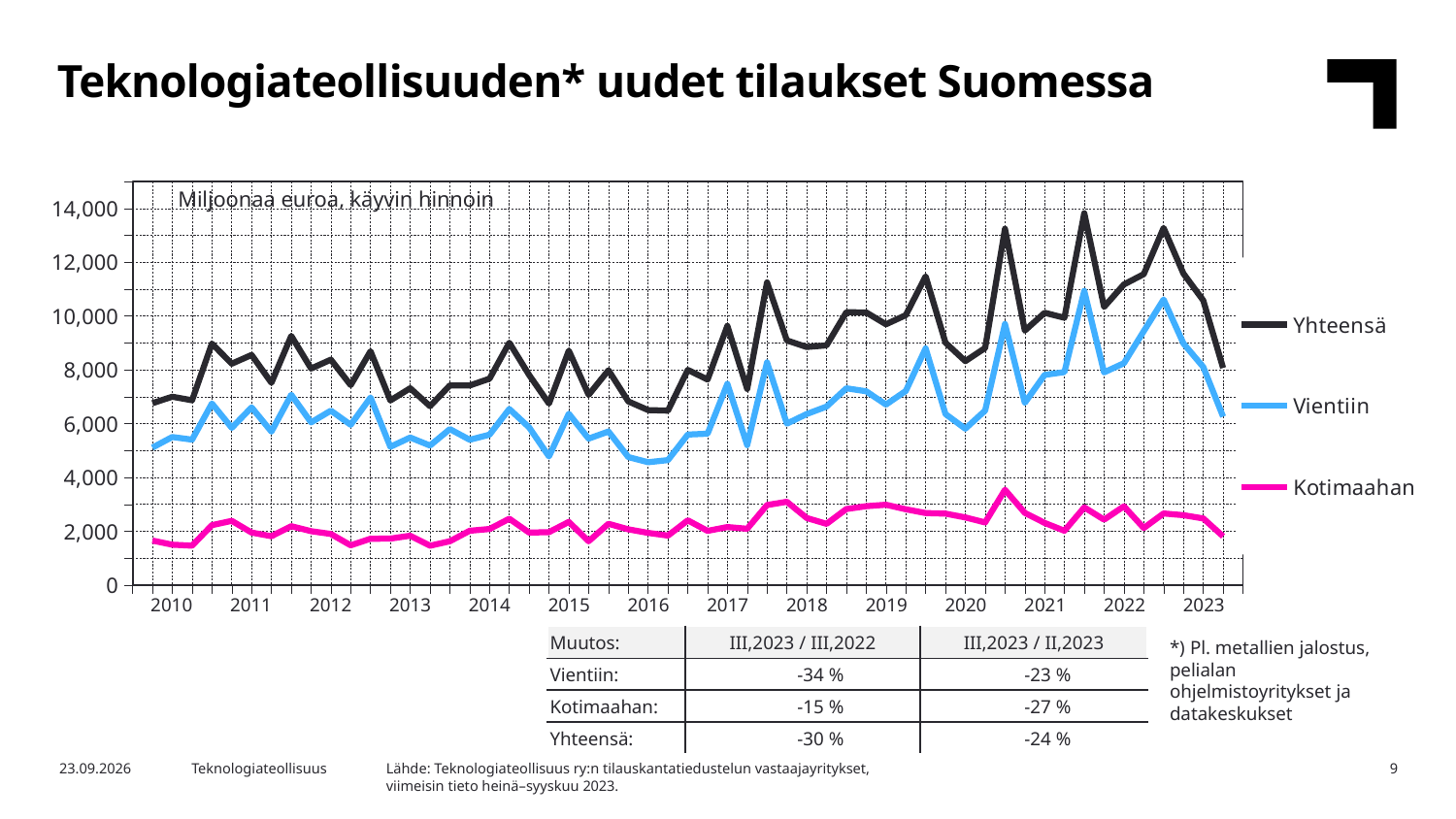
Is the value for Kotimaahan in 2010 greater or less than 4,000? less Does the Yhteensä line rise or fall from its 2022 peak to the end of 2023? fall How many year labels are shown on the x axis? 14 What kind of chart is shown on the slide? line chart Which series has the highest values throughout the chart? Yhteensä Which series are listed in the chart legend? Yhteensä, Vientiin, Kotimaahan Is the peak value for Yhteensä in 2021 greater or less than 12,000? greater How many series does the chart legend list? 3 Is the lowest value for Vientiin in 2016 greater or less than 6,000? less Which is larger in 2023, the value for Vientiin or the value for Kotimaahan? Vientiin What unit is stated in the chart's label at the top of the plot area? Miljoonaa euroa, käyvin hinnoin Which series has the lowest values throughout the chart? Kotimaahan